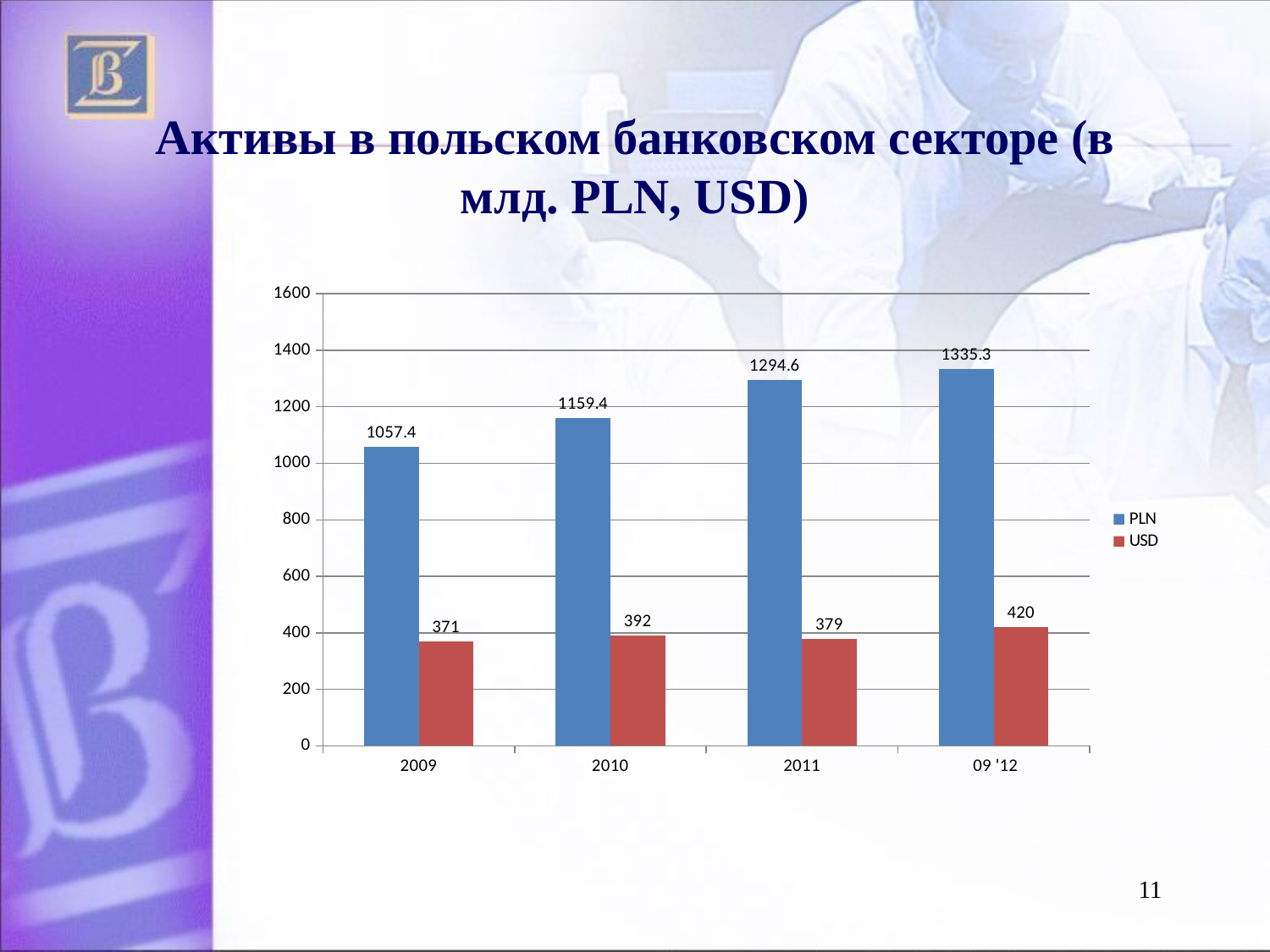
Which category has the lowest USD value? 2009 What is the difference between the USD values for 09 '12 and 2010? 28 Do the PLN values rise or fall from 2009 to 09 '12? rise How many series does the legend list? 2 What kind of chart is shown on the slide? bar chart What is the USD value for 2011? 379 Which is larger, the USD value for 2010 or the USD value for 2011? 2010 Which category has the highest PLN value? 09 '12 What is the difference between the PLN values for 2011 and 2009? 237.2 What is the PLN value for 2010? 1159.4 How many categories are shown on the x axis? 4 What is the PLN value for 09 '12? 1335.3